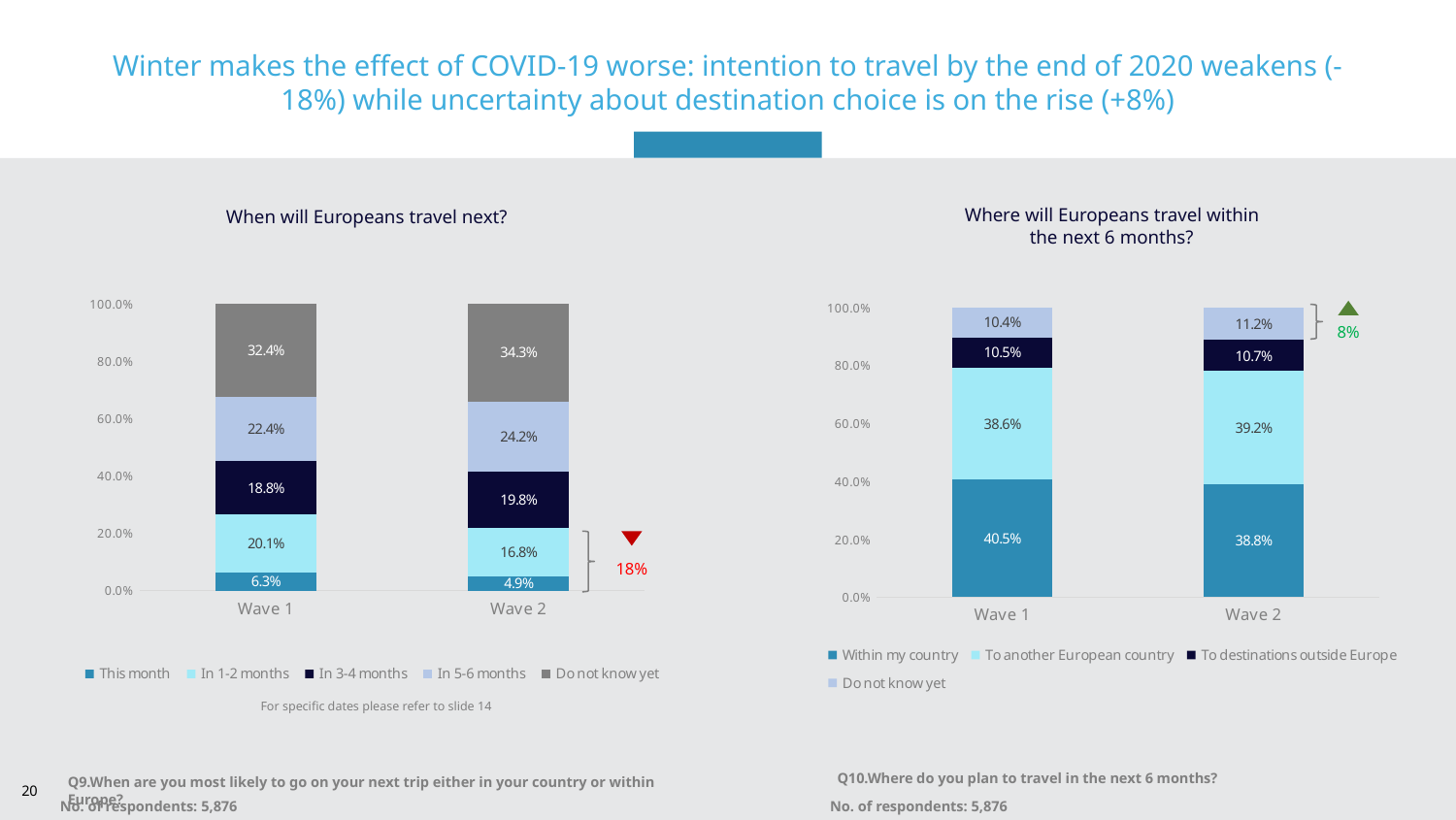
In the chart 'Where will Europeans travel within the next 6 months?', which is larger in Wave 2: 'Within my country' or 'To another European country'? To another European country In the chart 'When will Europeans travel next?', which segment is the largest in Wave 1? Do not know yet How many series does the legend of the chart 'When will Europeans travel next?' list? 5 What kind of chart is 'Where will Europeans travel within the next 6 months?'? Stacked bar chart In the chart 'When will Europeans travel next?', what is the value for 'Do not know yet' in Wave 2? 34.3% In the chart 'Where will Europeans travel within the next 6 months?', what is the difference between the 'Do not know yet' values for Wave 2 and Wave 1? 0.8% In the chart 'Where will Europeans travel within the next 6 months?', what is the value for 'Within my country' in Wave 2? 38.8% How many categories are shown on the x axis of the chart 'Where will Europeans travel within the next 6 months?'? 2 In the chart 'When will Europeans travel next?', what is the difference between the 'In 1-2 months' values for Wave 1 and Wave 2? 3.3% In the chart 'When will Europeans travel next?', what is the value for 'This month' in Wave 1? 6.3% In the chart 'When will Europeans travel next?', which segment is the smallest in Wave 2? This month In the chart 'Where will Europeans travel within the next 6 months?', what is the value for 'To destinations outside Europe' in Wave 1? 10.5%